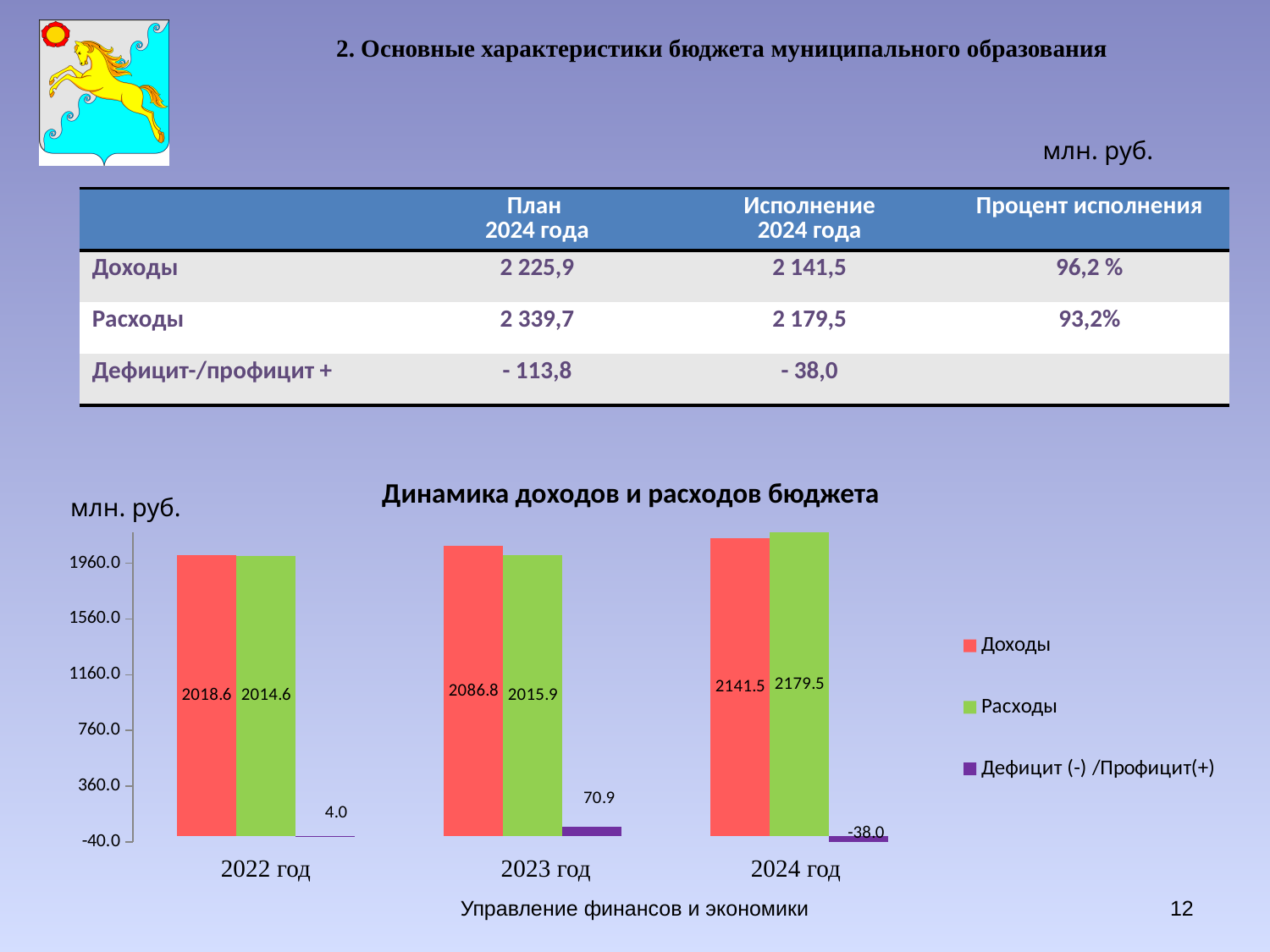
How many years are shown on the x axis of the chart? 3 How many series does the chart legend list? 3 In which year is Доходы highest in the chart? 2024 год What is the value of Доходы for 2023 год in the chart 'Динамика доходов и расходов бюджета'? 2086.8 What is the value of Расходы for 2024 год in the chart? 2179.5 Do the Доходы values rise or fall from 2022 год to 2024 год in the chart? rise In which year is Дефицит (-) /Профицит(+) lowest in the chart? 2024 год What type of chart is 'Динамика доходов и расходов бюджета'? bar chart What is the value of Дефицит (-) /Профицит(+) for 2024 год in the chart? -38.0 What is the value of Дефицит (-) /Профицит(+) for 2022 год in the chart? 4.0 Which is larger for 2023 год: Доходы or Расходы? Доходы What is the difference between Расходы and Доходы for 2024 год in the chart? 38.0